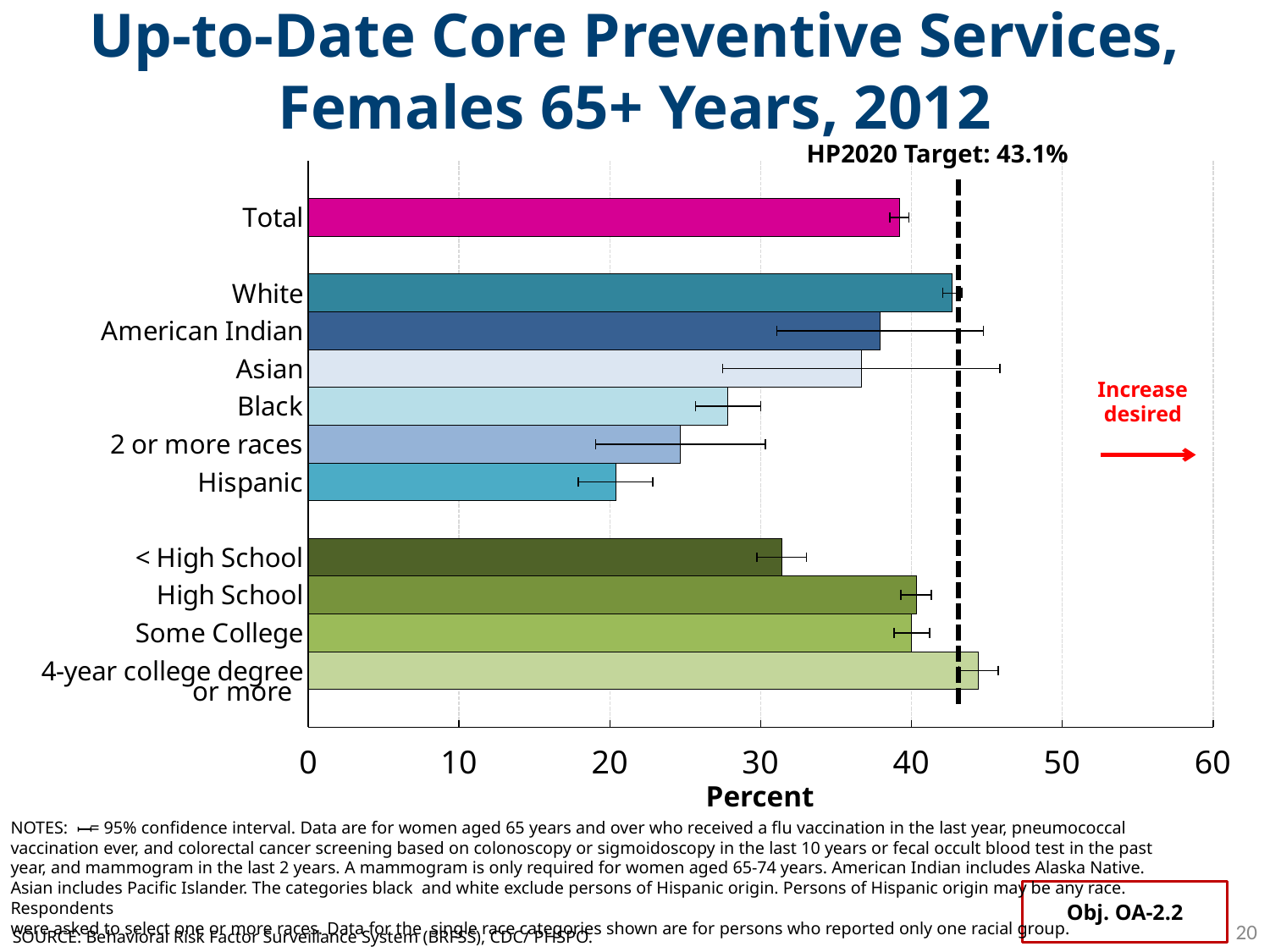
How many categories (bars) are plotted in the chart? 11 What is the label of the x axis? Percent What kind of chart is shown on the slide? bar chart Which is larger, the value for White or the value for American Indian? White What is the HP2020 Target value shown on the chart? 43.1% Which category has the highest value? 4-year college degree or more Which is larger, the value for Black or the value for Hispanic? Black Is the value for Black greater or less than 30? less Is the value for White greater or less than 40? greater Is the value for 2 or more races greater or less than 20? greater Which category has the lowest value? Hispanic